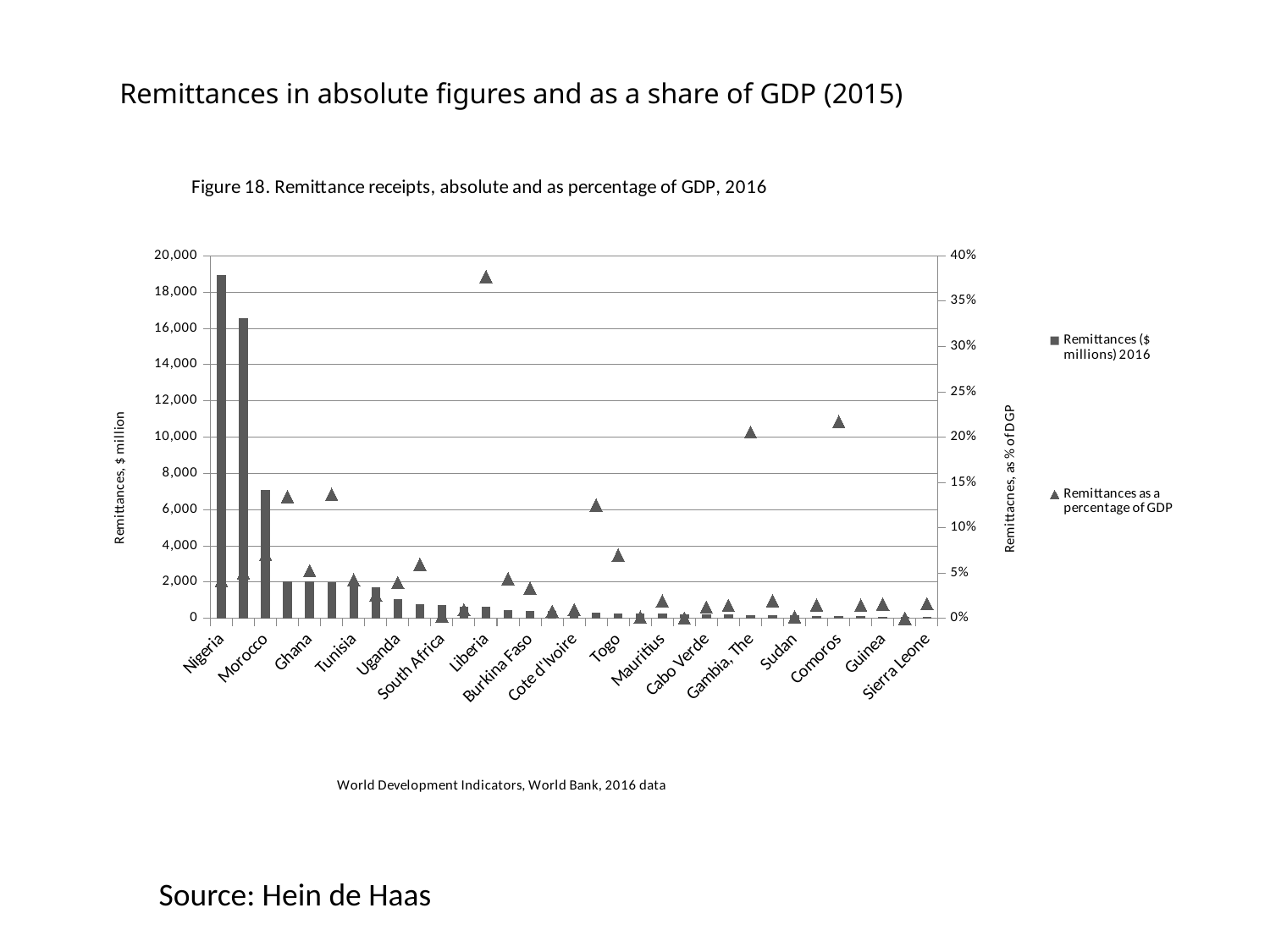
Do the Remittances ($ millions) 2016 bars generally rise or fall from left to right along the x axis? fall Which country has the highest value for Remittances as a percentage of GDP? Liberia Which country has the highest value for Remittances ($ millions) 2016? Nigeria What is the title of the chart? Figure 18. Remittance receipts, absolute and as percentage of GDP, 2016 Which is larger, the Remittances ($ millions) 2016 bar for Nigeria or for Morocco? Nigeria What is the label of the left vertical axis? Remittances, $ million What kind of chart is this? Bar chart with a second series plotted as triangle markers Is the Remittances ($ millions) 2016 value for Ghana greater or less than 6,000? less How many series does the chart legend list? 2 Is the Remittances as a percentage of GDP value for Comoros greater or less than 15%? greater Is the Remittances as a percentage of GDP value for Liberia greater or less than 35%? greater